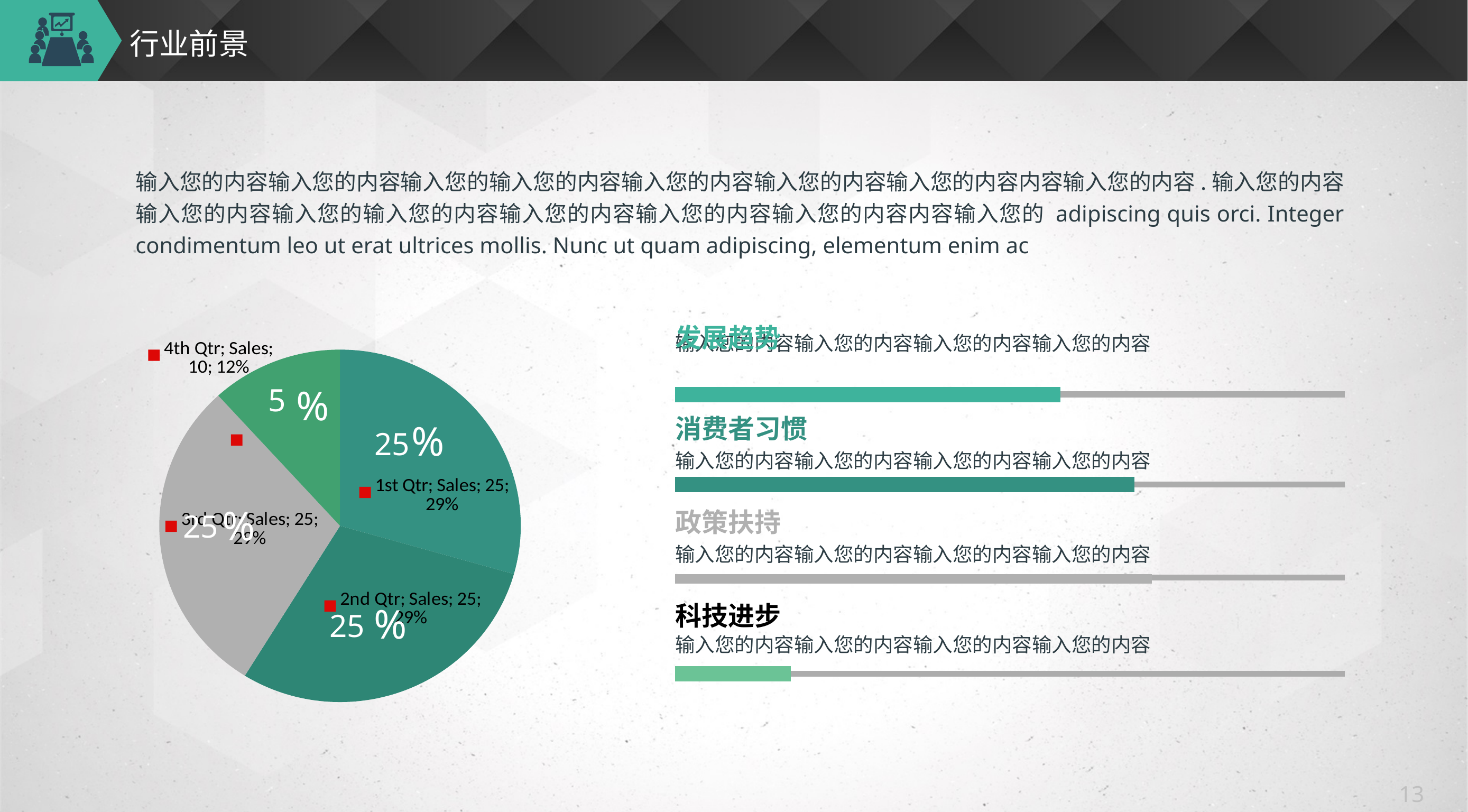
What is the difference between the Sales values for 1st Qtr and 4th Qtr? 15 What share of the pie does 4th Qtr represent? 12% How many slices does the pie chart have? 4 What is the total of all Sales values shown in the pie chart? 85 Which quarter has the smallest slice in the pie chart? 4th Qtr What is the Sales value for 1st Qtr in the pie chart? 25 What kind of chart is shown on the slide? Pie chart What share of the pie does 2nd Qtr represent? 29% Which is larger, the Sales value for 3rd Qtr or for 4th Qtr? 3rd Qtr What is the name of the data series plotted in the pie chart? Sales What is the Sales value for 4th Qtr in the pie chart? 10 What colour is the 3rd Qtr slice of the pie chart? Grey